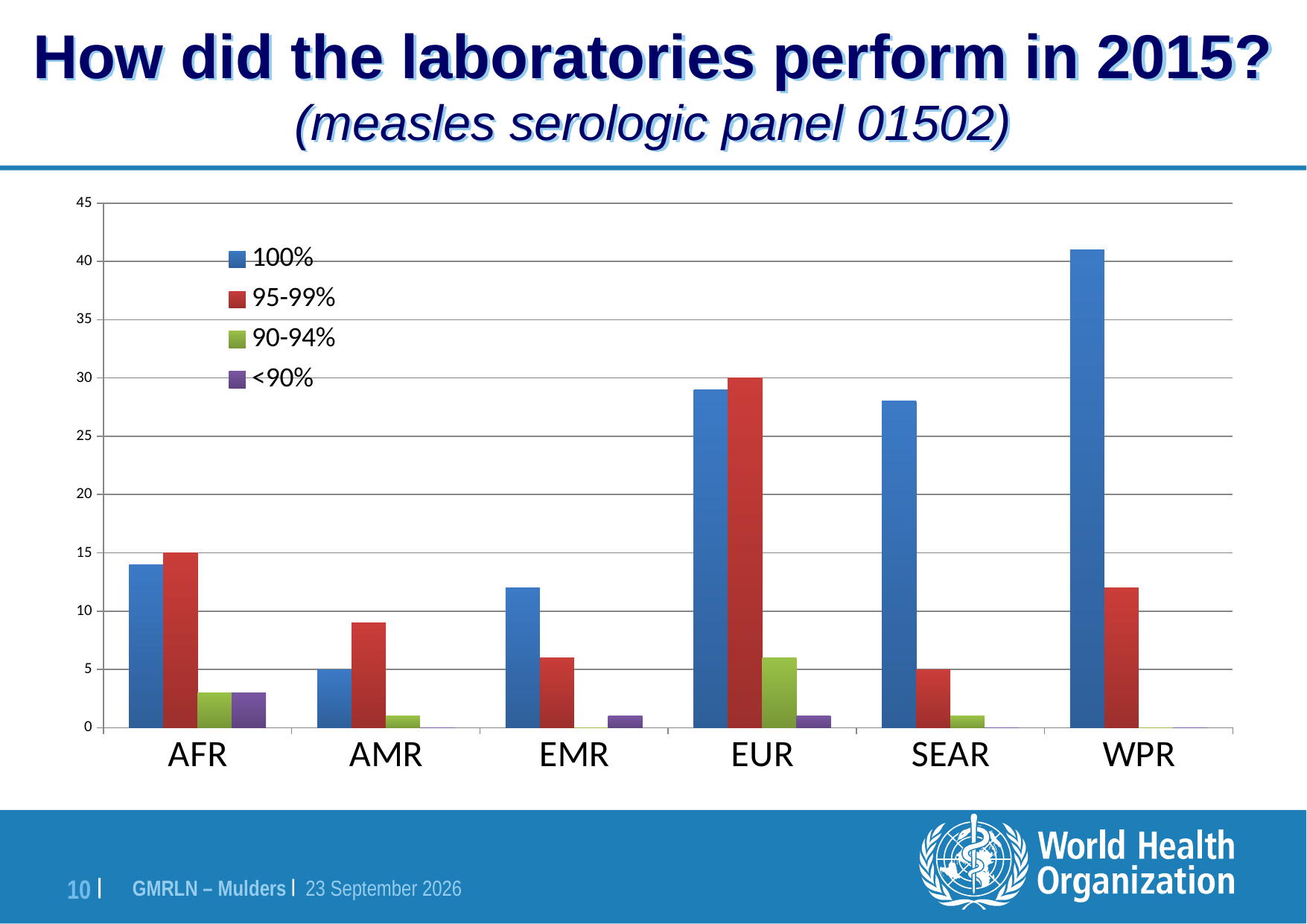
Which is larger in SEAR, the 100% series or the 95-99% series? 100% Which region has the lowest value for the 100% series? AMR How many regions are shown on the x axis? 6 Is the value for the 100% series in WPR greater or less than 40? greater Is the value for the 95-99% series in WPR greater or less than 15? less How many series does the legend list? 4 Which region has the highest value for the 100% series? WPR Which region has the highest value for the 95-99% series? EUR Is the value for the 100% series in SEAR greater or less than 25? greater Which is larger in EUR, the 100% series or the 95-99% series? 95-99% Which colour represents the <90% series in the legend? purple What kind of chart is shown on the slide? bar chart